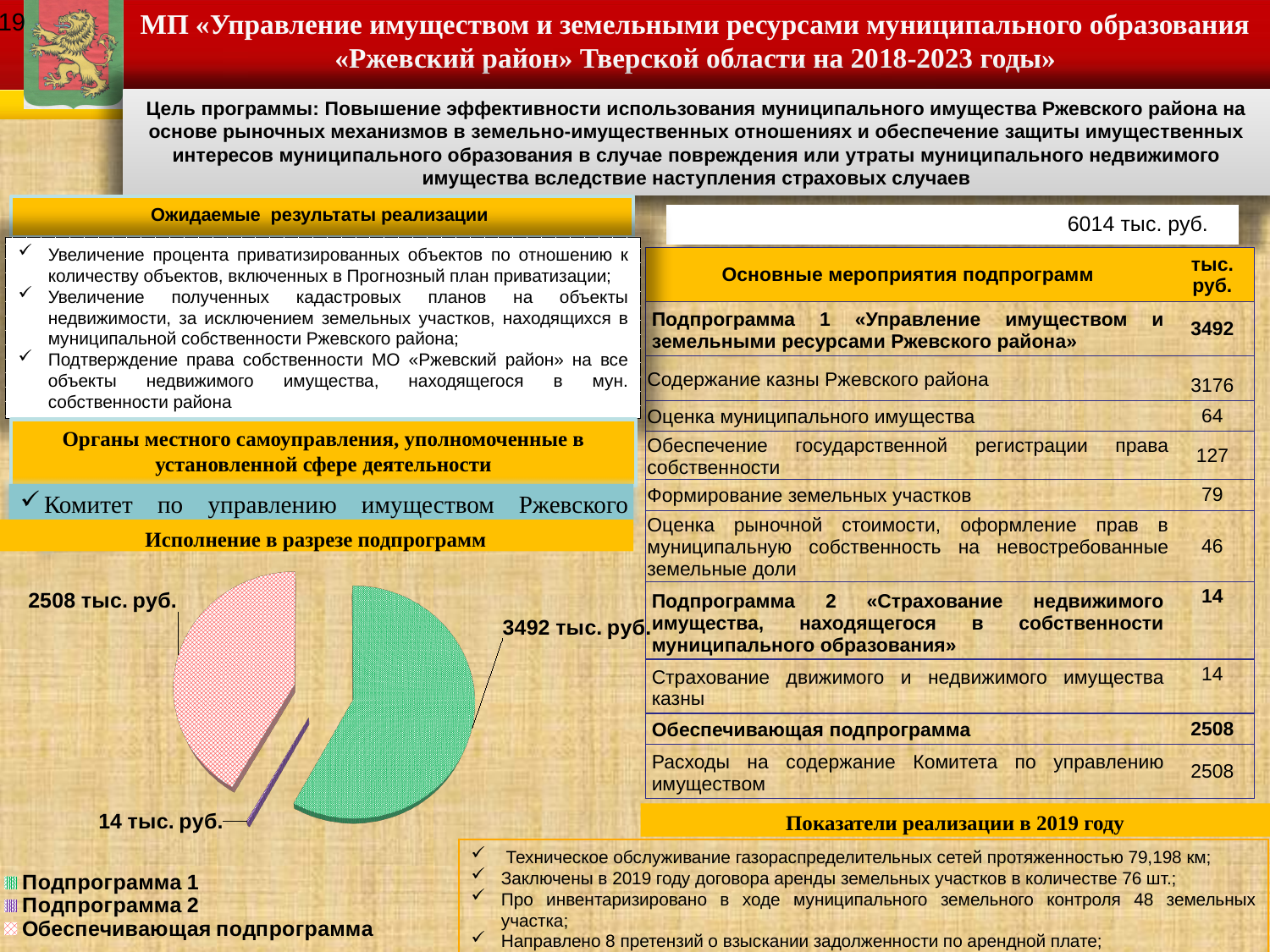
Which subprogram has the largest slice in the pie chart? Подпрограмма 1 What is the difference between the values for Подпрограмма 1 and Обеспечивающая подпрограмма in the pie chart? 984 тыс. руб. What is the total of all three slices in the pie chart? 6014 тыс. руб. Which subprogram has the smallest slice in the pie chart? Подпрограмма 2 How many slices does the pie chart have? 3 What type of chart is shown on the slide? pie chart How many entries does the legend of the pie chart list? 3 What is the title shown above the pie chart? Исполнение в разрезе подпрограмм What is the value of the slice for Обеспечивающая подпрограмма in the pie chart? 2508 тыс. руб. Which is larger in the pie chart: Обеспечивающая подпрограмма or Подпрограмма 2? Обеспечивающая подпрограмма What is the value of the slice for Подпрограмма 1 in the pie chart? 3492 тыс. руб. What is the value of the slice for Подпрограмма 2 in the pie chart? 14 тыс. руб.